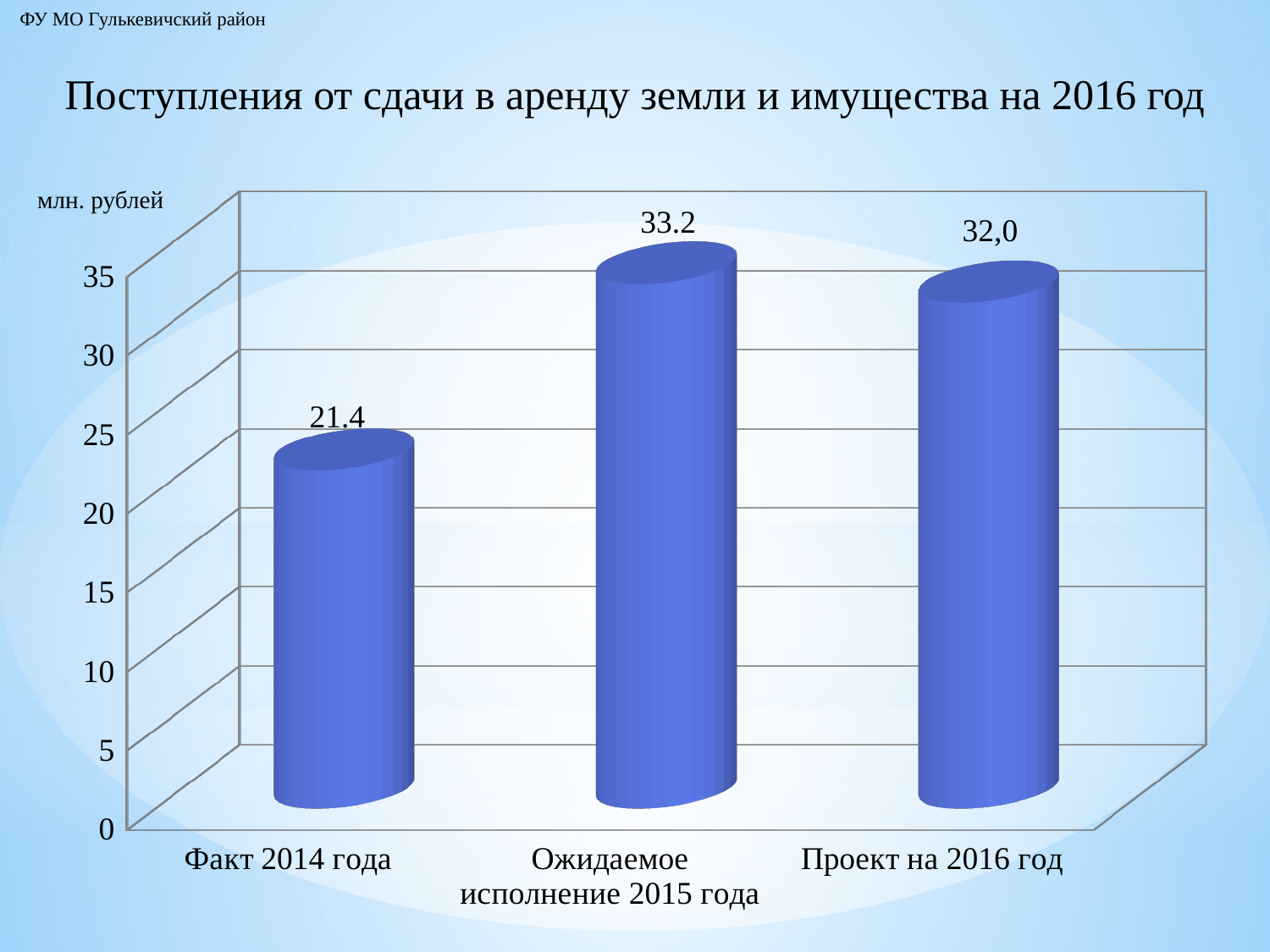
Is the value for Факт 2014 года greater or less than 25? less What is the value for Ожидаемое исполнение 2015 года? 33.2 What unit of measurement is indicated for the chart values? млн. рублей What kind of chart is shown on the slide? bar chart What is the value for Факт 2014 года? 21.4 Which is larger, the value for Ожидаемое исполнение 2015 года or the value for Проект на 2016 год? Ожидаемое исполнение 2015 года What is the difference between the values for Ожидаемое исполнение 2015 года and Факт 2014 года? 11.8 What is the value for Проект на 2016 год? 32,0 Which category has the lowest value? Факт 2014 года Which category has the highest value? Ожидаемое исполнение 2015 года How many categories are shown in the chart? 3 What is the difference between the values for Проект на 2016 год and Факт 2014 года? 10.6